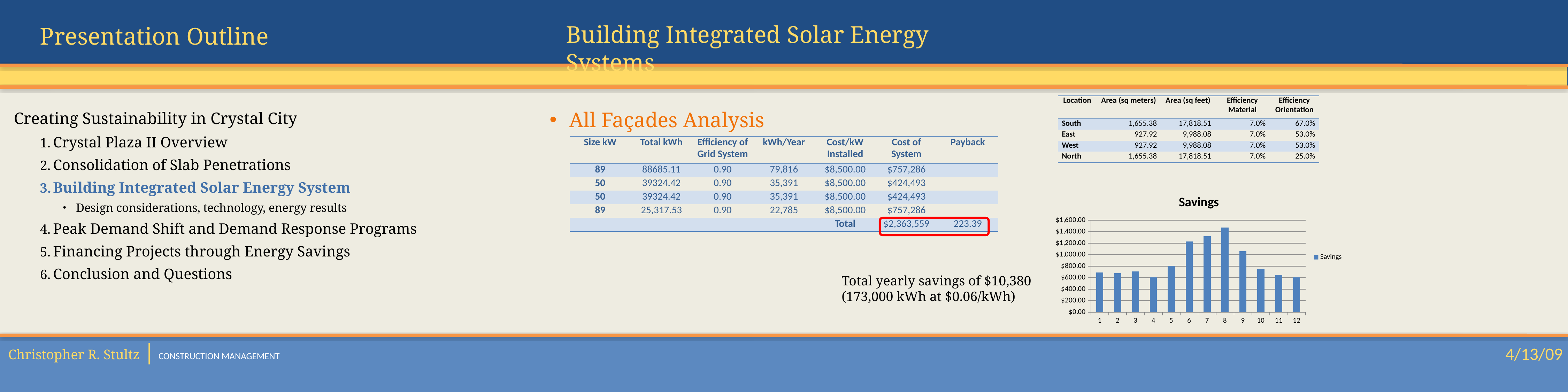
In the Savings chart, do the values rise or fall from category 8 to category 12? fall What is the title of the bar chart on the slide? Savings How many categories are shown on the x axis of the Savings chart? 12 In the Savings chart, which is larger, the value for category 6 or category 10? 6 What kind of chart is the Savings chart? bar chart In the Savings chart, is the value for category 1 greater or less than $1,000.00? less Which category has the highest value in the Savings chart? 8 In the Savings chart, is the value for category 6 greater or less than $1,000.00? greater In the Savings chart, is the value for category 4 greater or less than $800.00? less In the Savings chart, which is larger, the value for category 7 or category 2? 7 How many series does the legend of the Savings chart list? 1